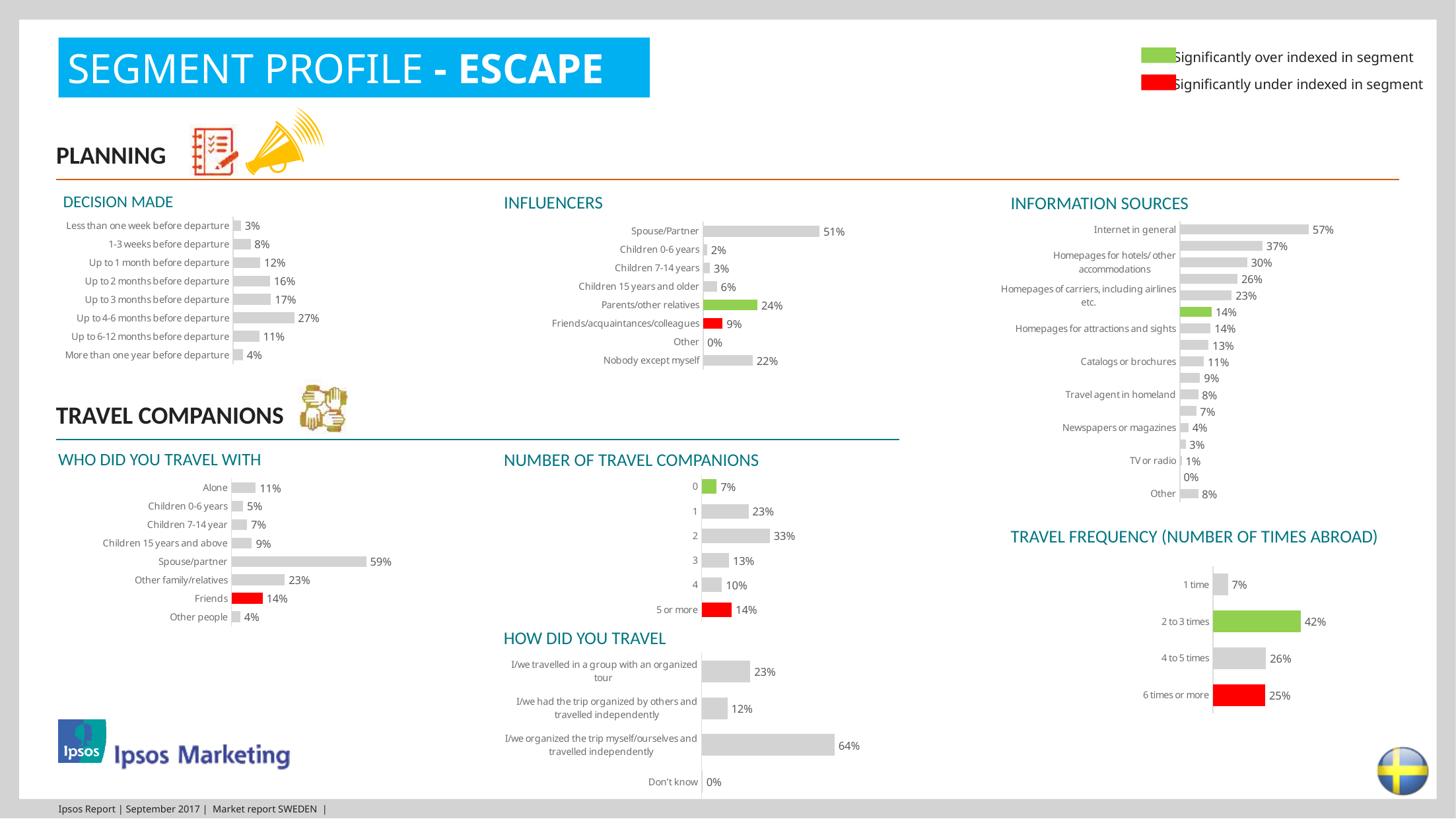
In the DECISION MADE chart, which category has the lowest value? Less than one week before departure In the NUMBER OF TRAVEL COMPANIONS chart, what is the value for '2'? 33% In the WHO DID YOU TRAVEL WITH chart, how many categories are shown? 8 In the INFLUENCERS chart, what is the value for 'Parents/other relatives'? 24% In the INFLUENCERS chart, what is the difference between 'Spouse/Partner' and 'Nobody except myself'? 29% What type of chart is the TRAVEL FREQUENCY (NUMBER OF TIMES ABROAD) chart? Bar chart In the INFORMATION SOURCES chart, what is the value for 'Internet in general'? 57% In the TRAVEL FREQUENCY (NUMBER OF TIMES ABROAD) chart, what is the difference between '2 to 3 times' and '6 times or more'? 17% In the DECISION MADE chart, what is the value for 'Up to 4-6 months before departure'? 27% In the WHO DID YOU TRAVEL WITH chart, which category has the highest value? Spouse/partner In the INFORMATION SOURCES chart, which is larger: 'Catalogs or brochures' or 'Travel agent in homeland'? Catalogs or brochures In the HOW DID YOU TRAVEL chart, what is the value for 'I/we organized the trip myself/ourselves and travelled independently'? 64%